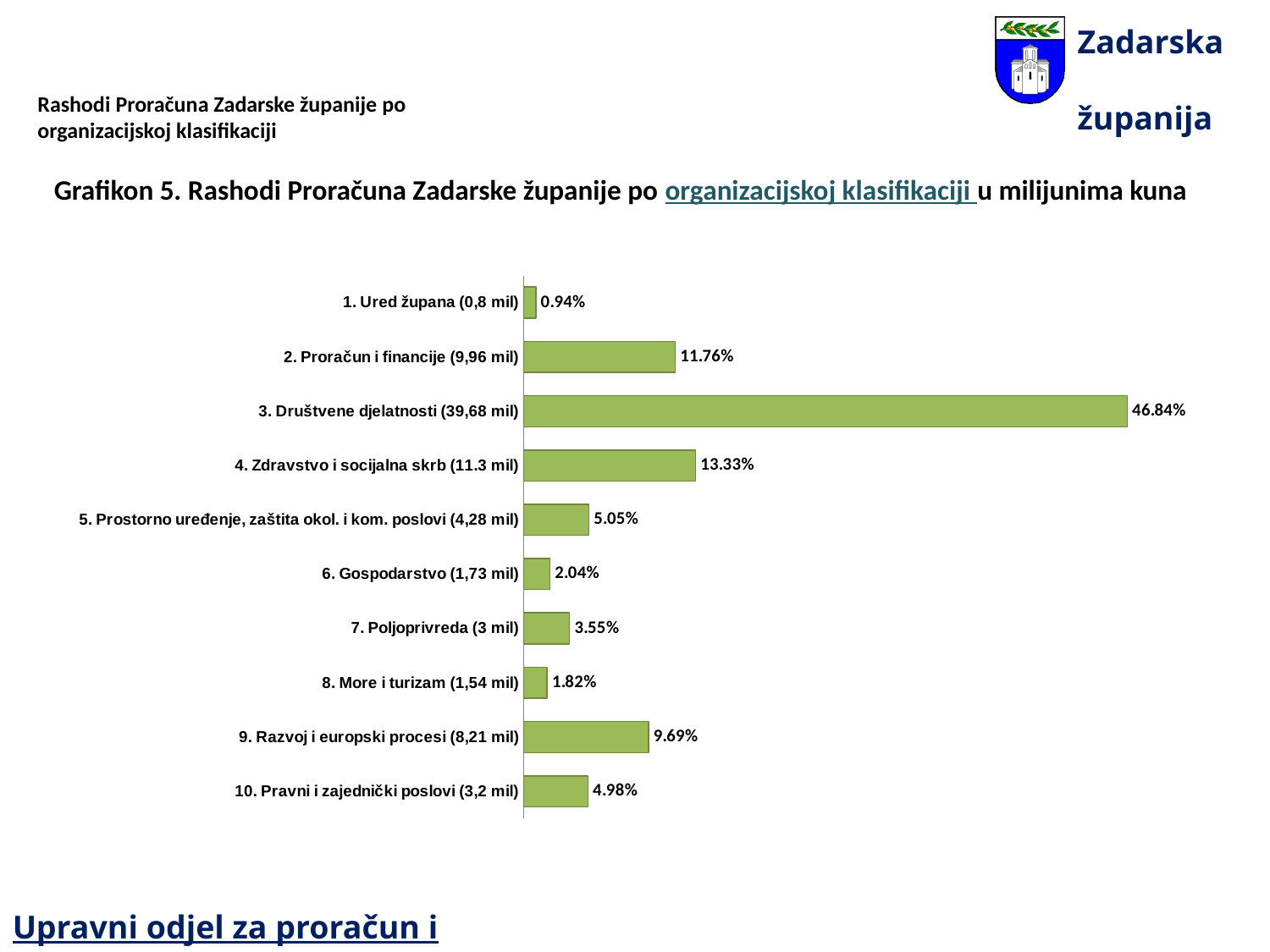
What percentage is shown for 9. Razvoj i europski procesi (8,21 mil)? 9.69% What percentage is shown for 6. Gospodarstvo (1,73 mil)? 2.04% What is the difference in percentage points between 3. Društvene djelatnosti and 1. Ured župana? 45.90 What percentage is shown for 3. Društvene djelatnosti (39,68 mil)? 46.84% Which category has the lowest percentage? 1. Ured župana (0,8 mil) What kind of chart is shown on the slide? Bar chart Which category has the highest percentage? 3. Društvene djelatnosti (39,68 mil) How many categories are shown in the chart? 10 What is the difference in percentage points between 4. Zdravstvo i socijalna skrb and 2. Proračun i financije? 1.57 Which has a larger percentage, 7. Poljoprivreda or 8. More i turizam? 7. Poljoprivreda What is the title of the chart? Grafikon 5. Rashodi Proračuna Zadarske županije po organizacijskoj klasifikaciji u milijunima kuna Which has a larger percentage, 5. Prostorno uređenje, zaštita okol. i kom. poslovi or 10. Pravni i zajednički poslovi? 5. Prostorno uređenje, zaštita okol. i kom. poslovi